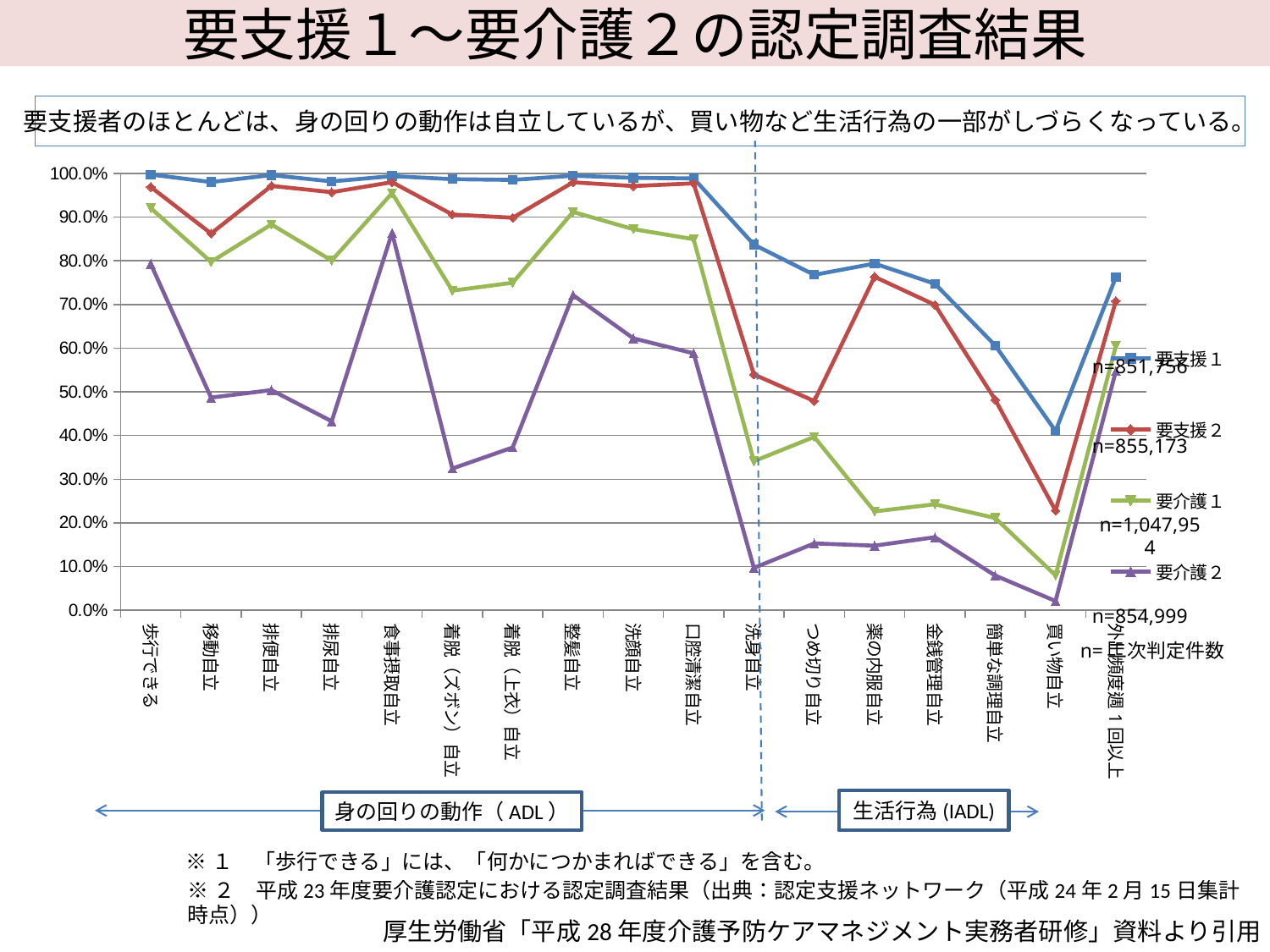
Is the value for 要支援2 at 薬の内服自立 greater or less than 70.0%? greater What n value is shown in the legend for 要支援2? n=855,173 Is the value for 要介護2 at 買い物自立 greater or less than 10.0%? less What kind of chart is shown on the slide? line chart For the 要介護2 series, which category has the lowest value? 買い物自立 Is the value for 要支援1 at 買い物自立 greater or less than 50.0%? less How many series does the legend list? 4 How many categories are shown along the x axis? 17 For the 要支援1 series, which category has the lowest value? 買い物自立 At 買い物自立, which series has the larger value, 要支援2 or 要介護1? 要支援2 For the 要介護2 series, which is larger, the value at 食事摂取自立 or at 着脱（ズボン）自立? 食事摂取自立